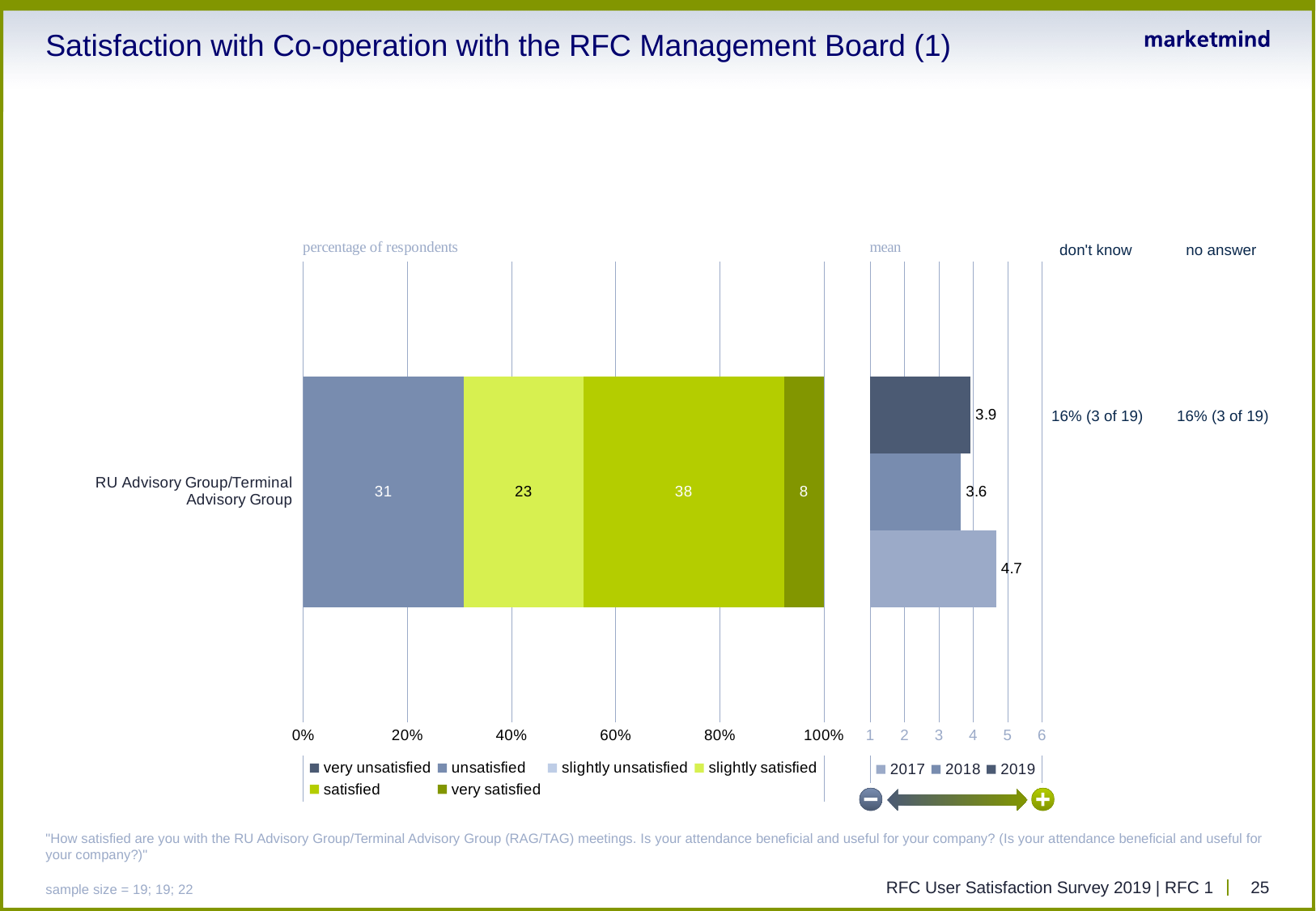
In the percentage of respondents chart, which response category has the largest share? satisfied In the percentage of respondents chart, what percentage of respondents are satisfied with the RU Advisory Group/Terminal Advisory Group? 38 In the mean chart, what is the difference between the 2017 mean and the 2018 mean? 1.1 In the percentage of respondents chart, how many categories does the legend list? 6 In the percentage of respondents chart, what percentage of respondents are unsatisfied? 31 In the mean chart, which year has the lowest mean? 2018 In the percentage of respondents chart, which response category has the smallest share among those shown in the bar? very satisfied In the mean chart, what is the mean for 2019? 3.9 What kind of chart is the percentage of respondents chart? stacked bar chart In the percentage of respondents chart, what percentage of respondents are very satisfied? 8 In the mean chart, what is the mean for 2017? 4.7 In the percentage of respondents chart, what is the difference between the satisfied and slightly satisfied shares? 15